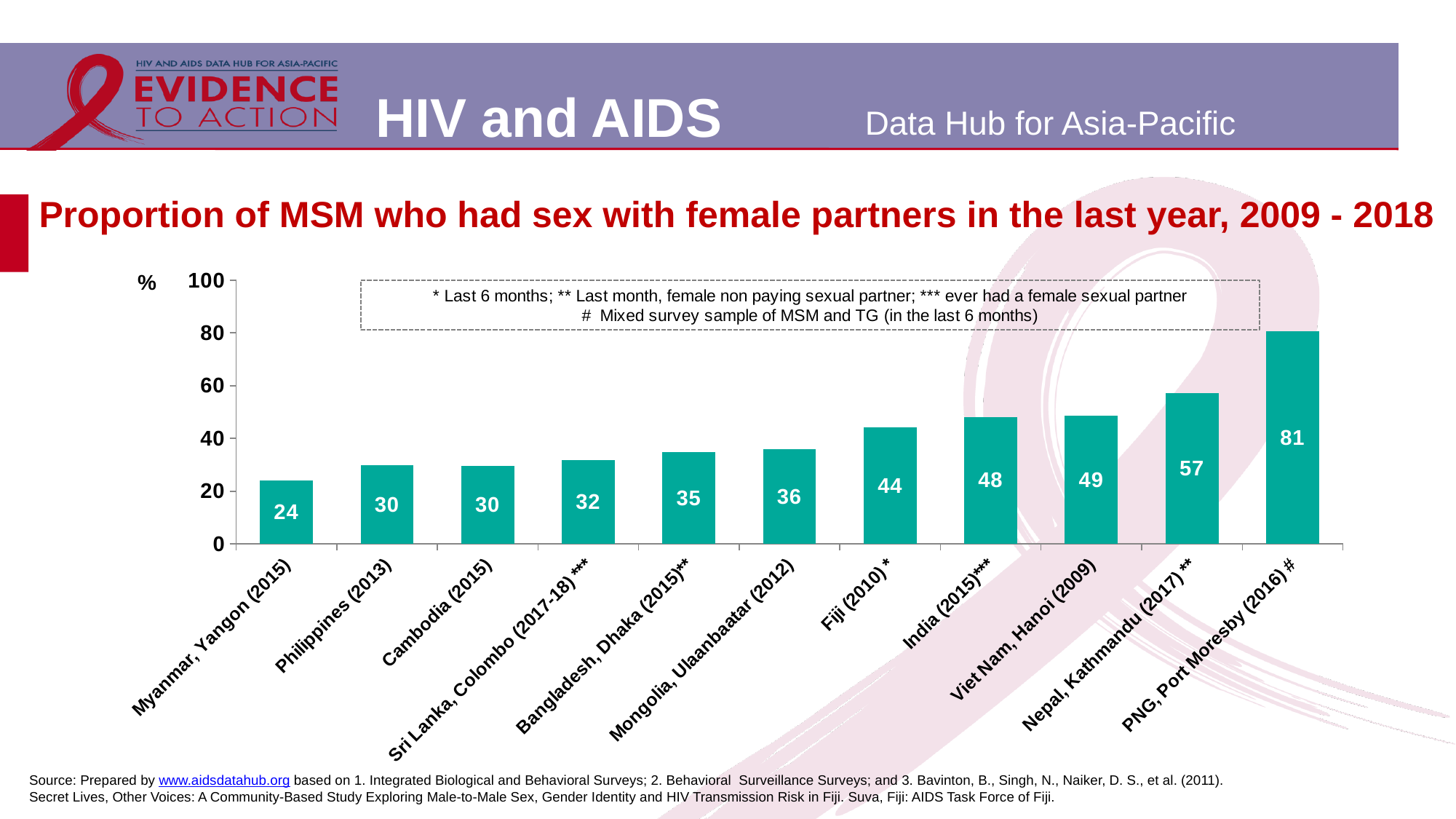
Which category has the highest value? PNG, Port Moresby (2016) Which is larger, the value for Bangladesh, Dhaka (2015) or the value for India (2015)? India (2015) Do the values rise or fall from left to right along the x axis? Rise How many categories are shown in the chart? 11 What is the value for Nepal, Kathmandu (2017)? 57 What is the difference between the values for PNG, Port Moresby (2016) and Myanmar, Yangon (2015)? 57 Which category has the lowest value? Myanmar, Yangon (2015) What is the value for Fiji (2010)? 44 What kind of chart is shown on the slide? Bar chart What is the title of the chart? Proportion of MSM who had sex with female partners in the last year, 2009 - 2018 Is the value for Viet Nam, Hanoi (2009) greater or less than 40? greater What is the value for Myanmar, Yangon (2015)? 24